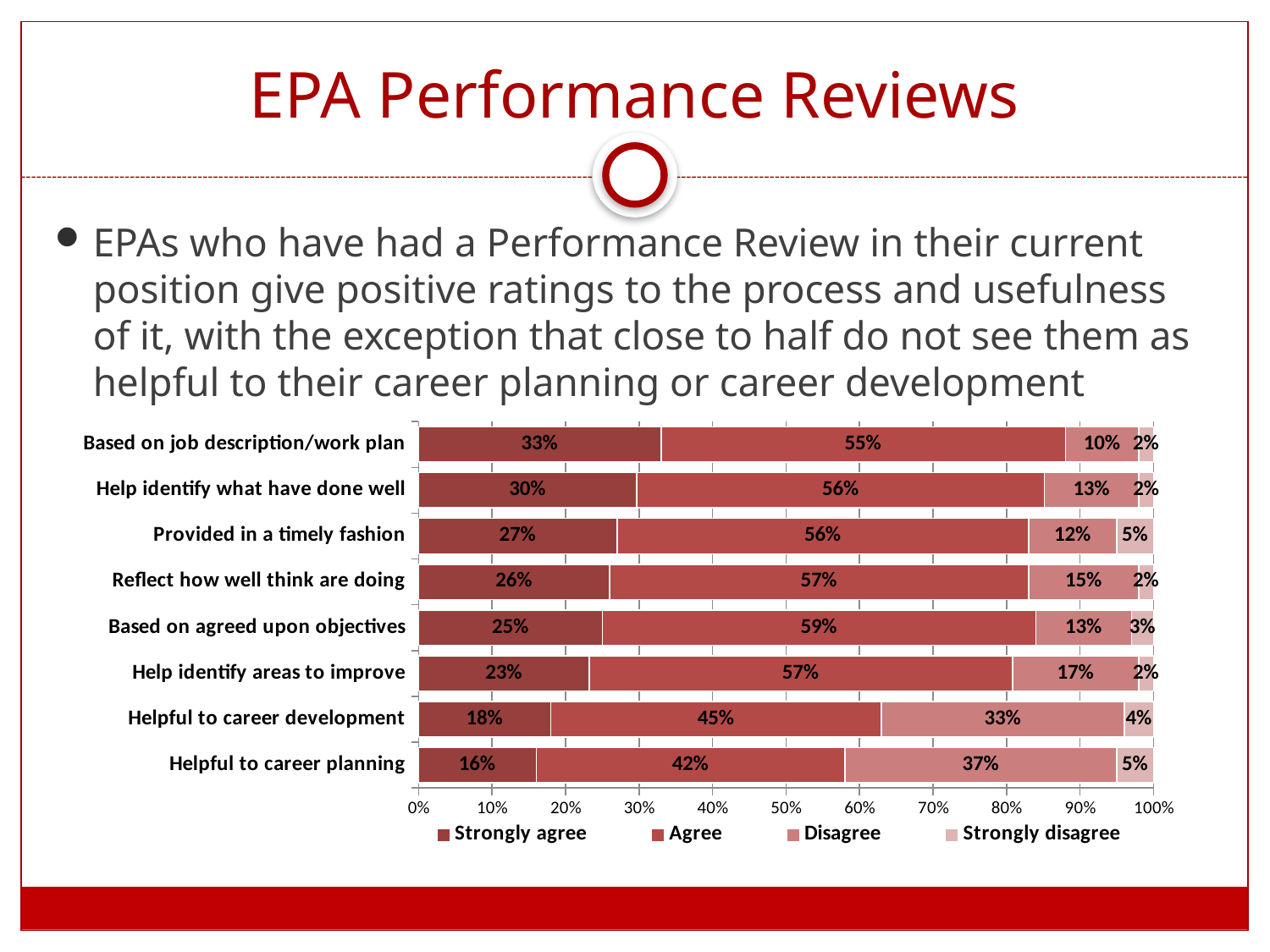
How many categories are shown on the chart? 8 What is the Agree value for "Based on agreed upon objectives"? 59% Which category has the lowest Strongly agree value? Helpful to career planning What is the difference between the Disagree values for "Helpful to career planning" and "Helpful to career development"? 4 percentage points What is the Strongly disagree value for "Provided in a timely fashion"? 5% What kind of chart is shown on the slide? Stacked bar chart Which category has the highest Strongly agree value? Based on job description/work plan What percentage of respondents strongly agree that performance reviews are based on job description/work plan? 33% What is the total of the stacked bar for "Helpful to career planning"? 100% What is the Disagree value for "Helpful to career planning"? 37% How many series does the legend list? 4 Which has a larger Agree value: "Help identify areas to improve" or "Helpful to career development"? Help identify areas to improve